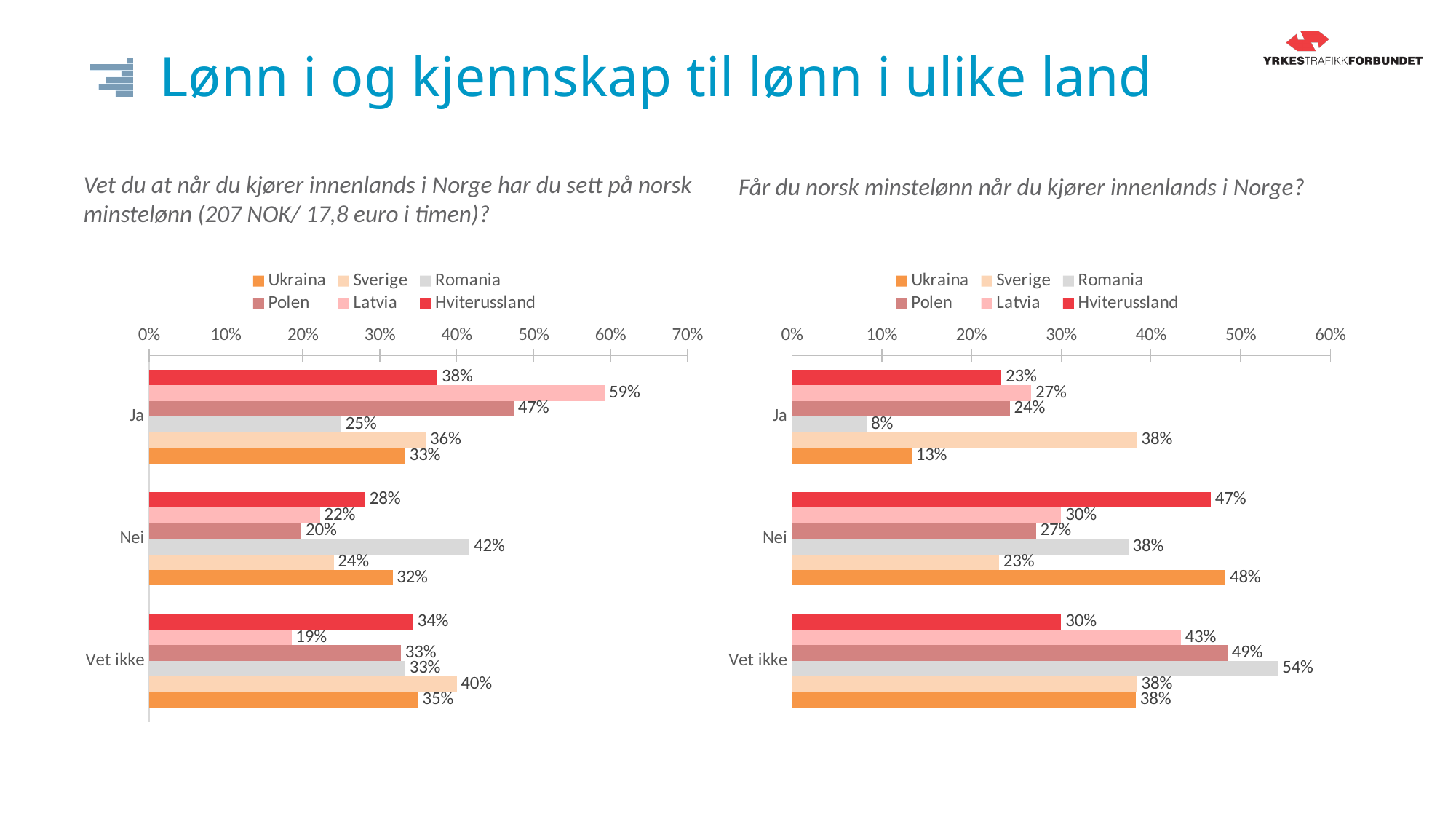
How many categories are shown on the vertical axis of the left chart? 3 In the left chart, what is the difference between Latvia and Polen in the 'Ja' category? 12% In the right chart, which country has the lowest value in the 'Ja' category? Romania In the left chart, what is the value for Romania in the 'Nei' category? 42% What type of chart is the left chart? Bar chart In the right chart, which country has the highest value in the 'Vet ikke' category? Romania In the right chart, what is the value for Ukraina in the 'Nei' category? 48% How many series does the legend of the right chart list? 6 In the left chart, what percentage of Latvia respondents answered 'Ja'? 59% In the right chart, which is larger in the 'Nei' category: Hviterussland or Latvia? Hviterussland In the right chart, what percentage of Romania respondents answered 'Ja'? 8% In the left chart, which country has the highest value in the 'Ja' category? Latvia